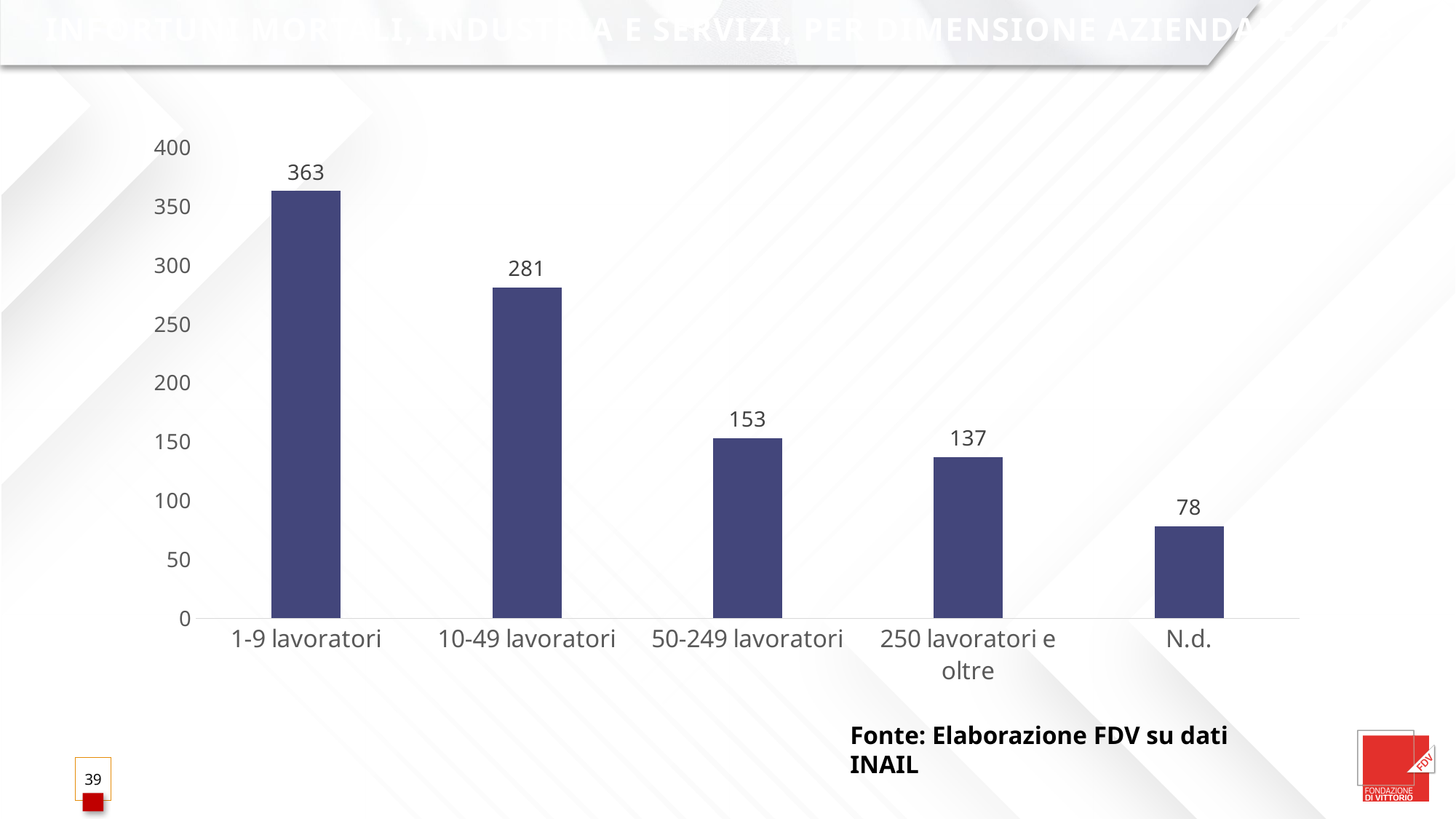
What kind of chart is shown on the slide? Bar chart How many categories are shown on the x axis? 5 What is the difference between the values for 1-9 lavoratori and 10-49 lavoratori? 82 What is the value for N.d.? 78 Which is larger, the value for 50-249 lavoratori or the value for 250 lavoratori e oltre? 50-249 lavoratori What is the value for 1-9 lavoratori? 363 Which category has the lowest value? N.d. Do the values rise or fall from left to right along the x axis? Fall What is the value for 250 lavoratori e oltre? 137 Which category has the highest value? 1-9 lavoratori What is the value for 10-49 lavoratori? 281 What is the value for 50-249 lavoratori? 153